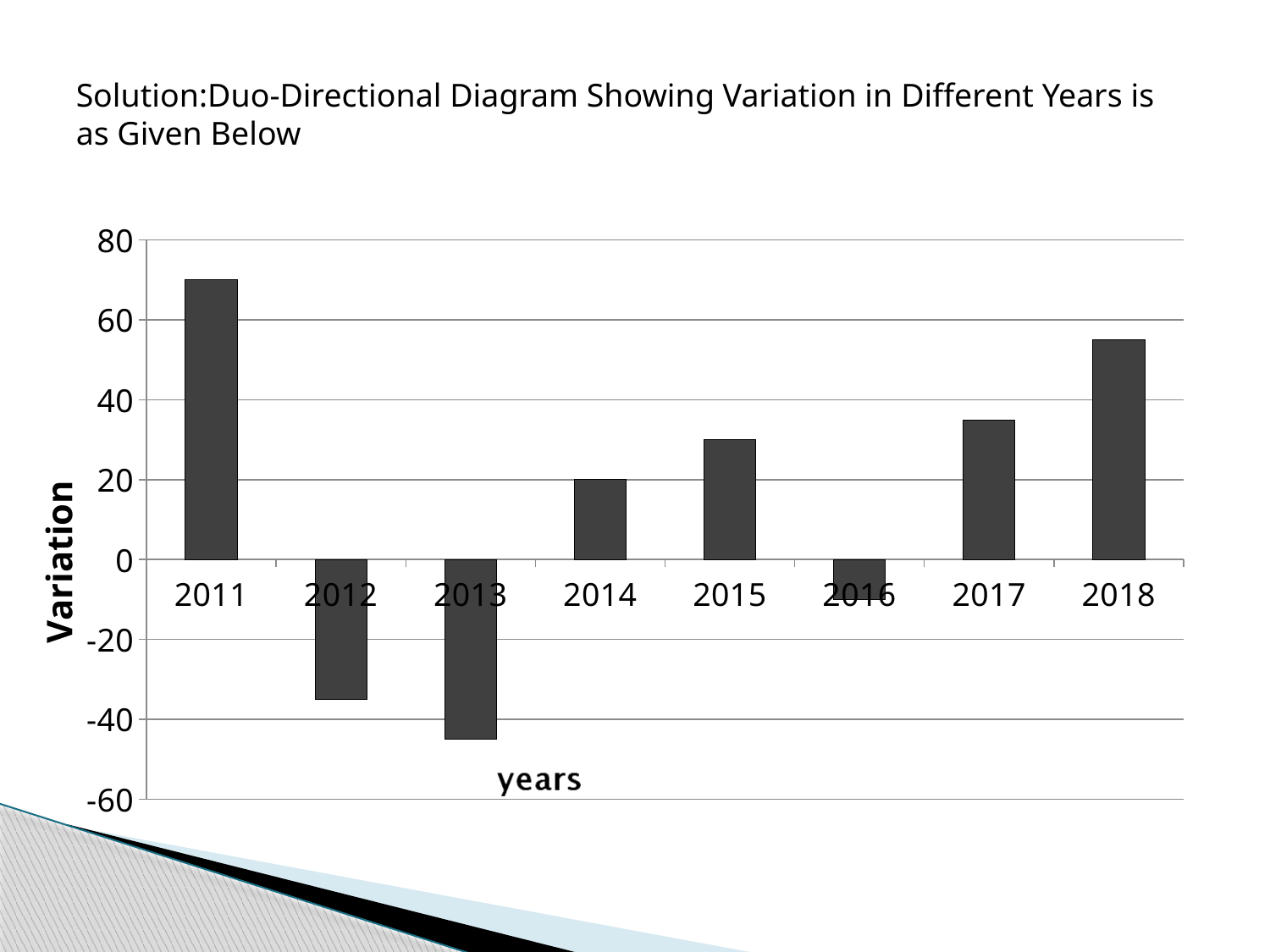
Which year has the highest variation? 2011 What is the title of the vertical axis? Variation Is the variation for 2016 greater or less than 0? less Which year has the larger variation, 2011 or 2018? 2011 Which year has the lowest variation? 2013 Is the variation for 2011 greater or less than 60? greater Is the variation for 2018 greater or less than 40? greater What kind of chart is shown on the slide? bar chart What is the variation value for 2014? 20 Which year has the lower variation, 2012 or 2013? 2013 How many years are plotted on the chart? 8